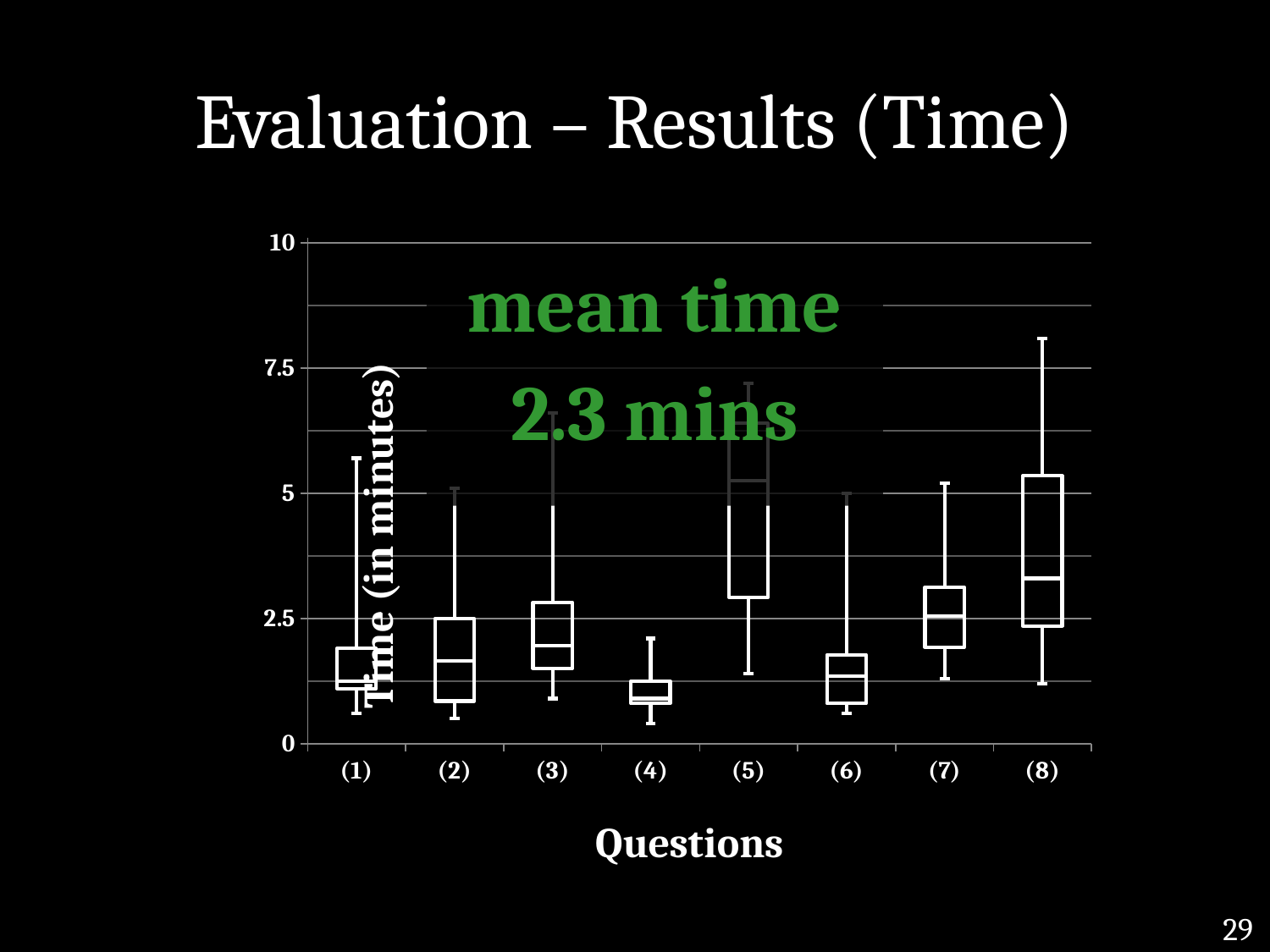
What is the label of the x axis of the chart? Questions Is the upper whisker for question (8) greater or less than 7.5 minutes? greater Which question has the lowest median time? (4) Which question has the highest upper whisker (maximum time)? (8) What kind of chart is shown on the slide? box plot Is the median time for question (5) larger or smaller than the median time for question (8)? larger How many questions are plotted along the x axis of the chart? 8 What is the mean time stated on the chart? 2.3 mins Which question has the highest median time? (5) Is the upper whisker for question (4) greater or less than 2.5 minutes? less What is the label of the y axis of the chart? Time (in minutes) Is the upper whisker for question (5) greater or less than 5 minutes? greater